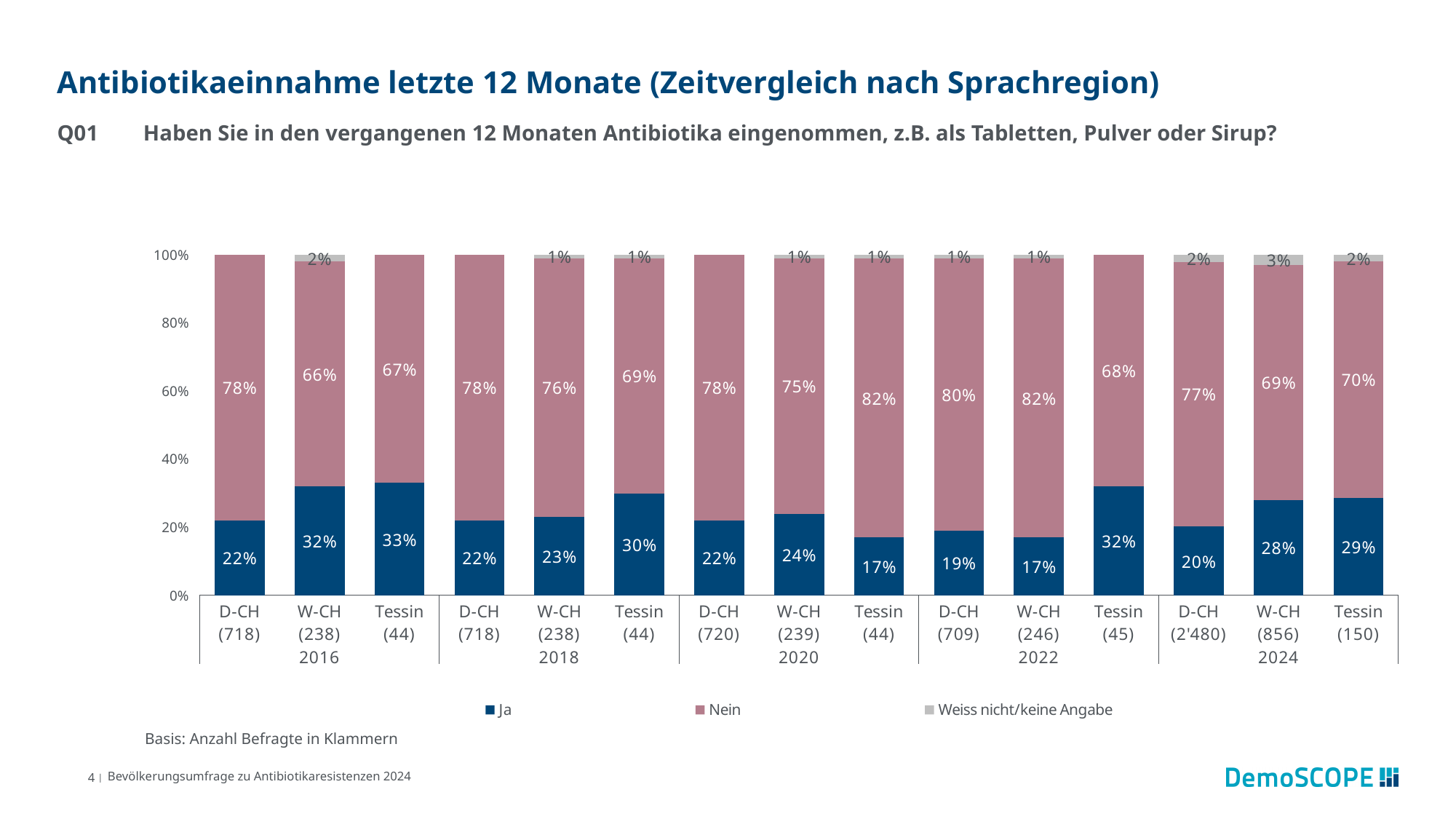
Which has a larger 'Ja' share: Tessin in 2022 or Tessin in 2024? Tessin in 2022 How many series does the legend list? 3 What kind of chart is shown on the slide? Stacked bar chart Which series is shown in dark blue? Ja How many bars are shown in the chart? 15 What is the 'Ja' value for D-CH (2'480) in 2024? 20% What is the 'Nein' value for Tessin (44) in 2018? 69% Which bar has the lowest 'Nein' share? W-CH (238) 2016 What is the difference in 'Ja' share between W-CH (856) and D-CH (2'480) in 2024? 8 percentage points Which bar has the highest 'Ja' share? Tessin (44) 2016 How does the 'Ja' share for D-CH change from 2016 to 2020? It stays the same at 22% What is the 'Weiss nicht/keine Angabe' value for W-CH (856) in 2024? 3%